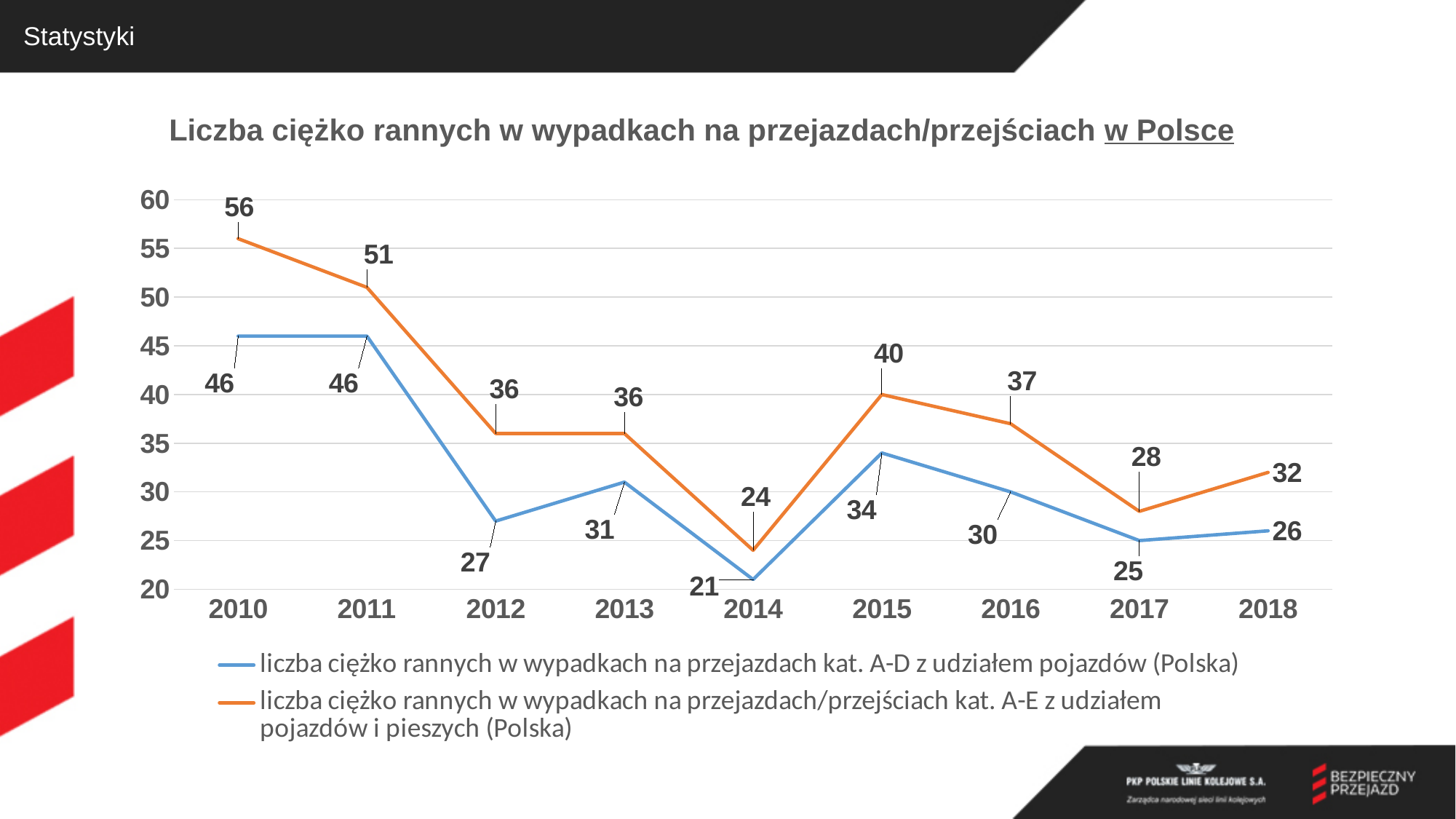
What is the title of the chart? Liczba ciężko rannych w wypadkach na przejazdach/przejściach w Polsce What is the difference between the orange and blue series values in 2012? 9 How many years are shown on the x axis? 9 Which is larger: the blue series value in 2015 or the blue series value in 2016? 2015 What is the value of the orange series (kat. A-E) in 2017? 28 In which year is the blue series (kat. A-D) at its lowest? 2014 What is the value of the blue series (kat. A-D, pojazdów) in 2014? 21 What is the value of the orange series (kat. A-E, pojazdów i pieszych) in 2010? 56 In which year is the orange series (kat. A-E) at its highest? 2010 How many series does the legend list? 2 What kind of chart is shown on the slide? line chart Does the orange series rise or fall from 2010 to 2014? fall